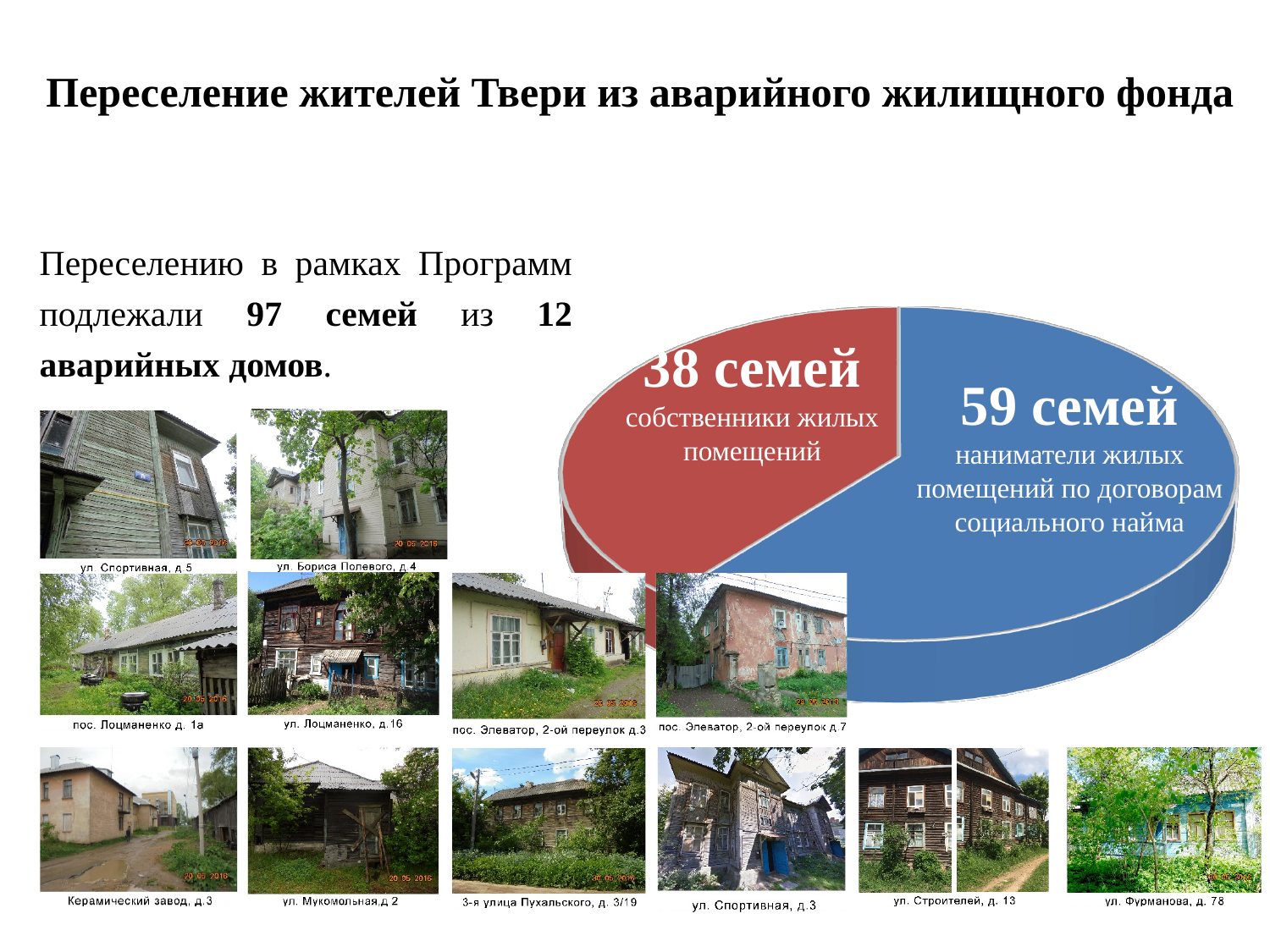
What is the total number of families across both slices of the pie chart? 97 семей What kind of chart is shown on the slide? pie chart How many families are shown in the slice for наниматели жилых помещений по договорам социального найма? 59 семей Which slice of the pie chart is the smallest? собственники жилых помещений (38 семей) How many slices does the pie chart have? 2 Which slice of the pie chart is the largest? наниматели жилых помещений по договорам социального найма (59 семей) How many families are shown in the slice for собственники жилых помещений? 38 семей What colour is the slice for 59 семей (наниматели жилых помещений)? blue What colour is the slice for 38 семей (собственники жилых помещений)? red What is the difference in the number of families between the наниматели slice and the собственники slice? 21 семья Which group has more families: собственники жилых помещений or наниматели жилых помещений? наниматели жилых помещений